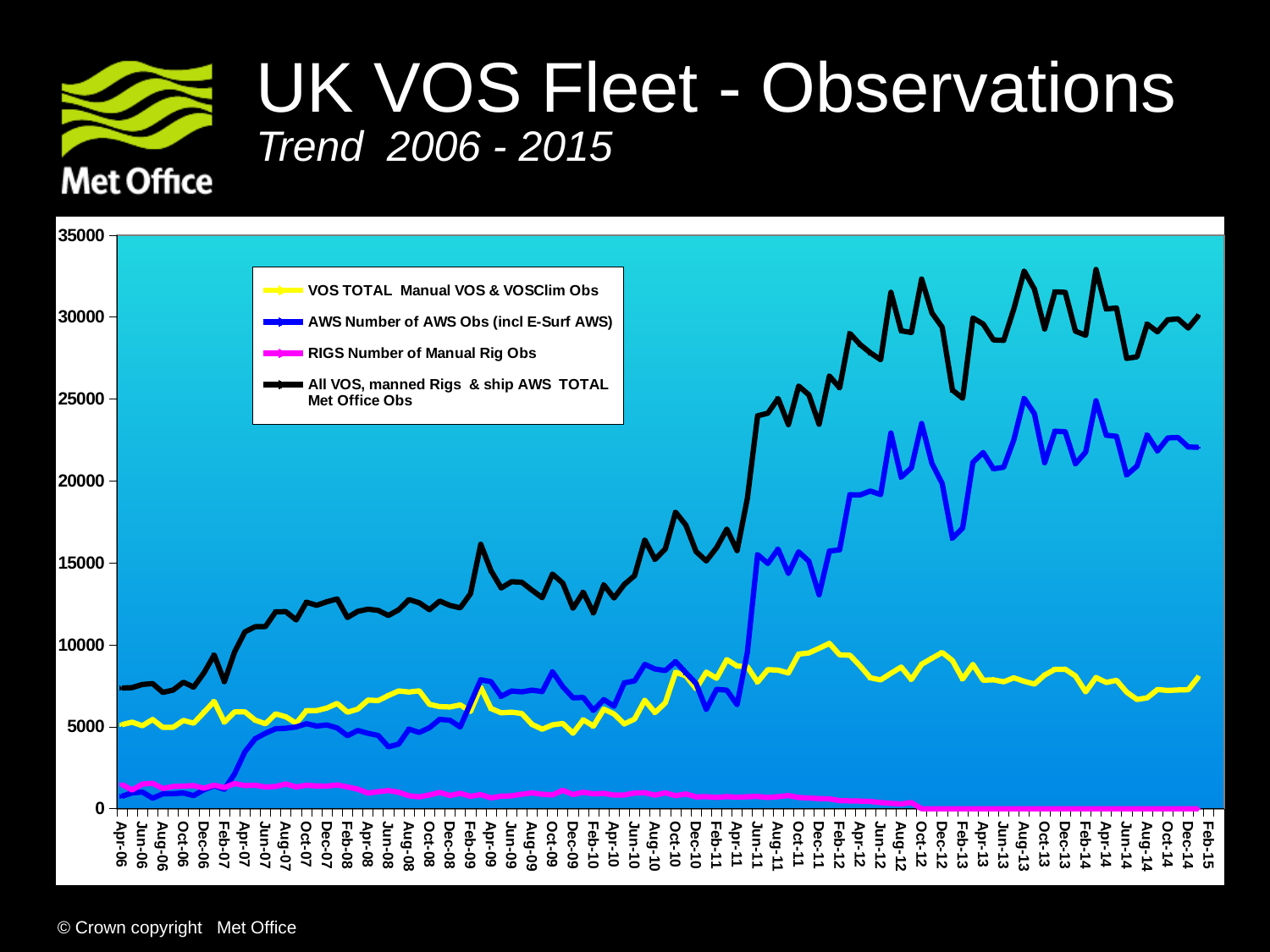
How many series does the legend list? 4 Does the All VOS, manned Rigs & ship AWS TOTAL Met Office Obs series generally rise or fall from Apr-06 to Feb-15? rise Does the RIGS Number of Manual Rig Obs series generally rise or fall from Apr-06 to Feb-15? fall Which series is drawn in yellow? VOS TOTAL Manual VOS & VOSClim Obs Is the value of the AWS Number of AWS Obs series at Apr-06 greater or less than 5000? less What kind of chart is shown on the slide? line chart Which series is drawn in black? All VOS, manned Rigs & ship AWS TOTAL Met Office Obs